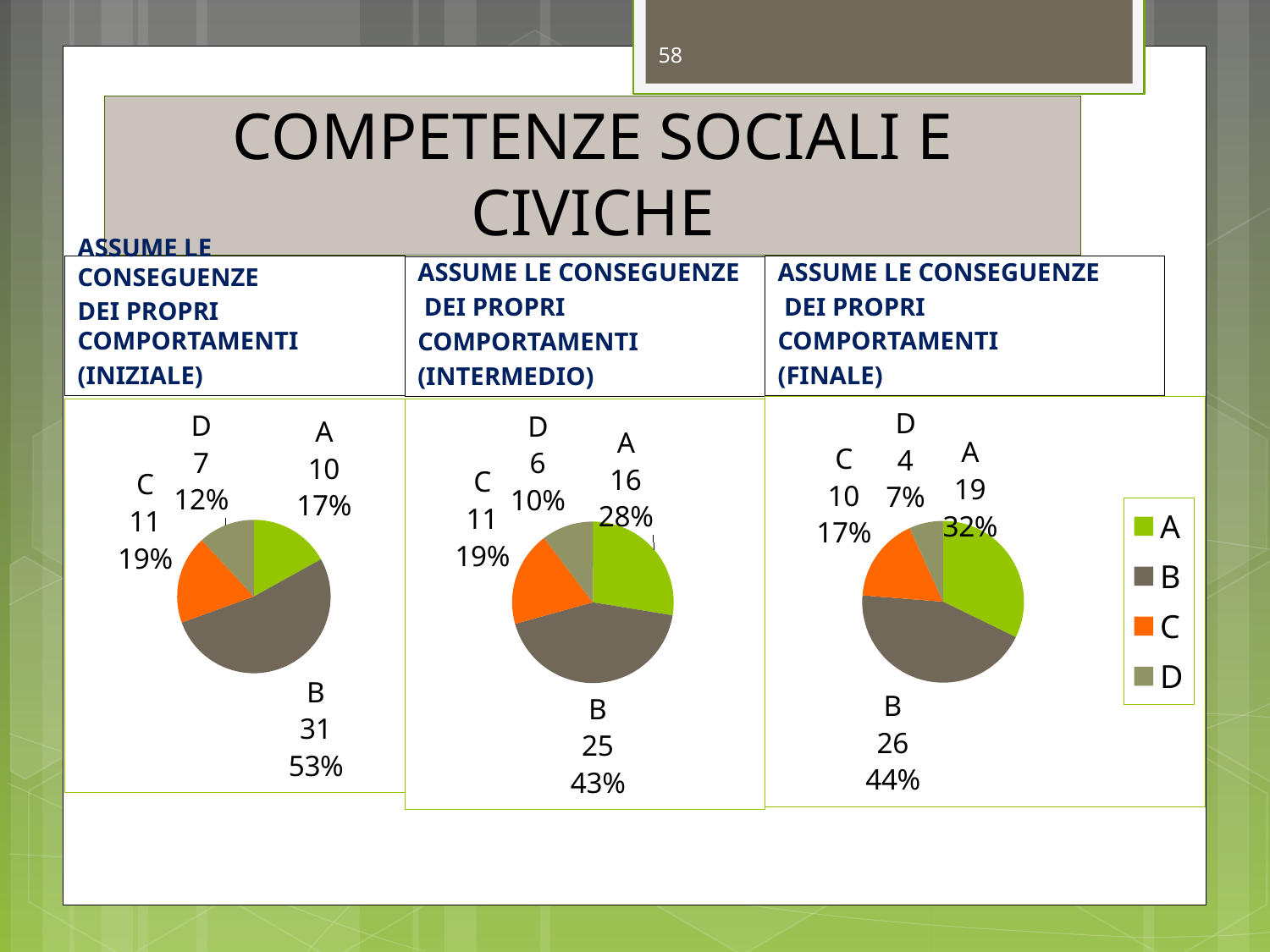
In the FINALE pie chart (right), which category has the largest value? B In the FINALE pie chart (right), what is the value for category D? 4 In the INIZIALE pie chart (left), which category has the smallest value? D What type of chart is used for the FINALE data (right)? Pie chart In the FINALE pie chart (right), which is larger, the value for A or the value for C? A How many categories does the INIZIALE pie chart (left) show? 4 In the INTERMEDIO pie chart (middle), what is the value for category A? 16 In the FINALE pie chart (right), what share of the pie does category A represent? 32% In the INTERMEDIO pie chart (middle), what share of the pie does category D represent? 10% In the INTERMEDIO pie chart (middle), what is the difference between the values for B and A? 9 In the INIZIALE pie chart (left), what share of the pie does category C represent? 19% In the INIZIALE pie chart (left), what is the value for category B? 31